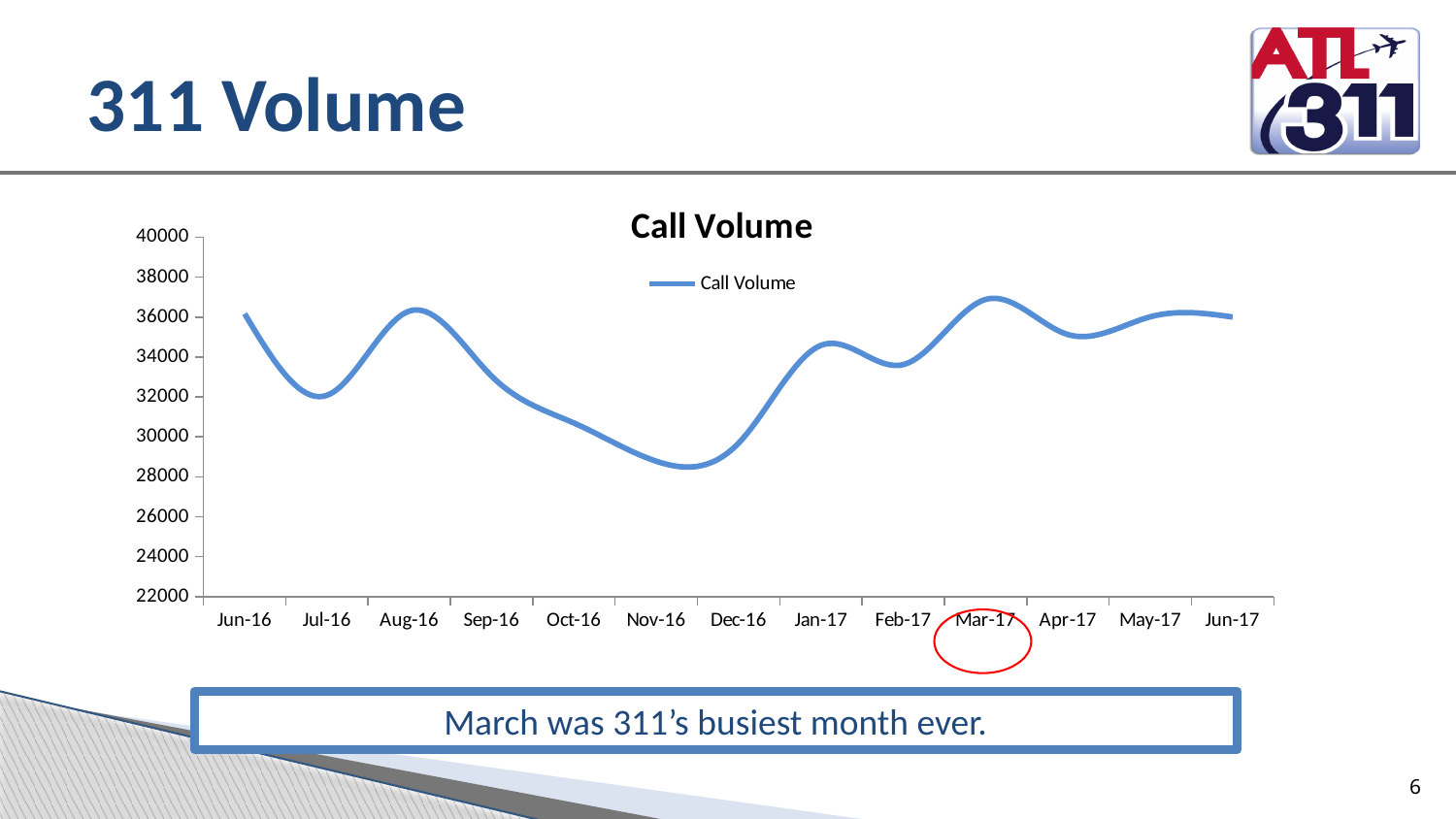
How many series does the legend list? 1 What kind of chart is shown on the slide? line chart Is the call volume for Mar-17 greater or less than 36000? greater How many months are plotted on the x axis? 13 Is the call volume for Jul-16 greater or less than 34000? less Does the call volume rise or fall from Dec-16 to Mar-17? rise Which month has the larger call volume, Jun-16 or Jul-16? Jun-16 What is the title of the chart? Call Volume Which month has the lowest call volume? Nov-16 Which month has the larger call volume, Dec-16 or Jan-17? Jan-17 Which month has the highest call volume? Mar-17 Is the call volume for Dec-16 greater or less than 30000? less